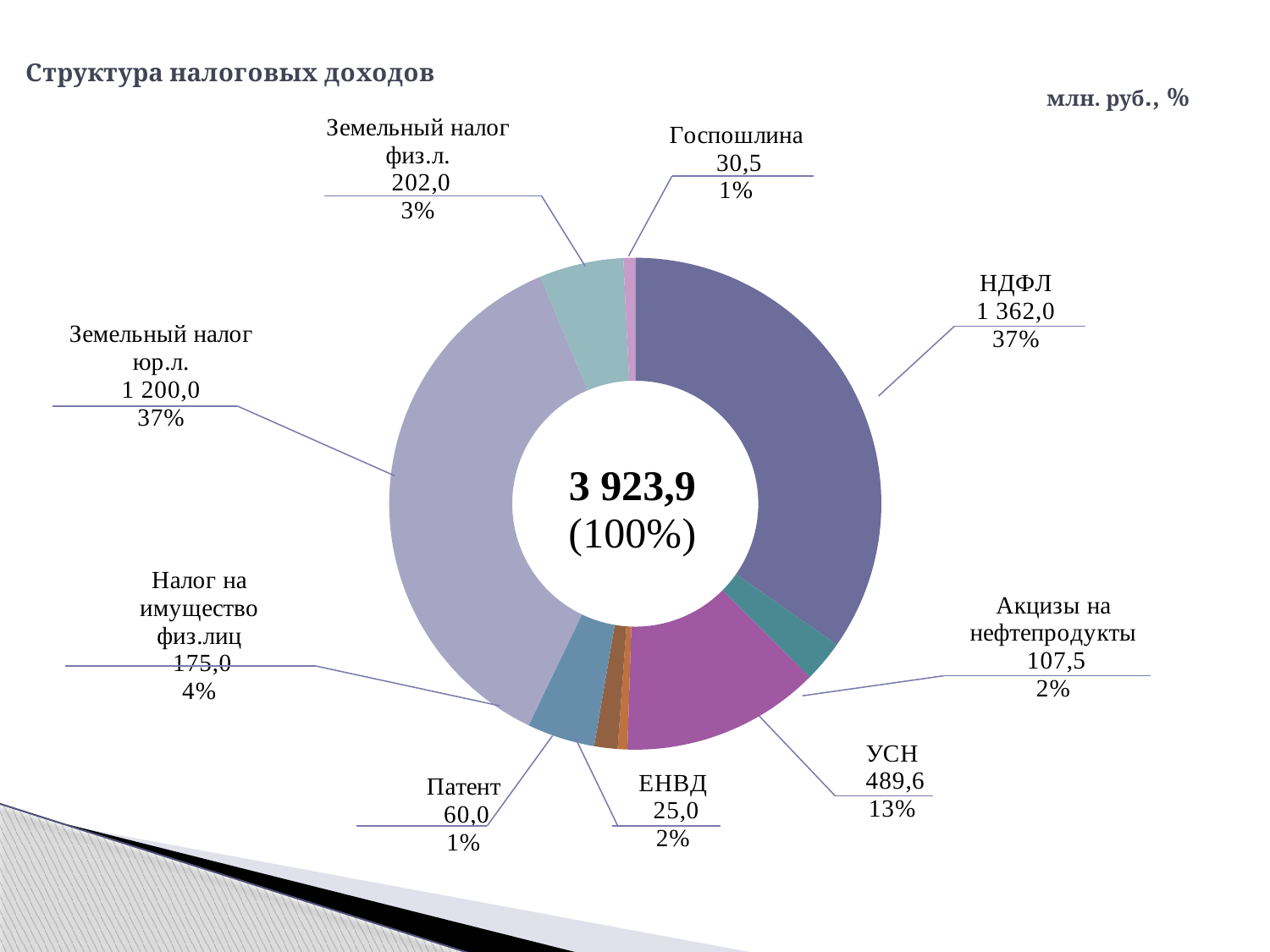
What is the difference between the values for НДФЛ and Земельный налог юр.л.? 162,0 Which is larger, the value for Земельный налог физ.л. or the value for Налог на имущество физ.лиц? Земельный налог физ.л. How many categories does the chart show? 9 Which category has the lowest value? ЕНВД What share of the total does Налог на имущество физ.лиц represent? 4% What is the value for Земельный налог юр.л.? 1 200,0 What is the value for Госпошлина? 30,5 Which category has the highest value? НДФЛ What is the value for НДФЛ? 1 362,0 What is the value for УСН? 489,6 What kind of chart is shown on the slide? Pie (doughnut) chart What share of the total does УСН represent? 13%